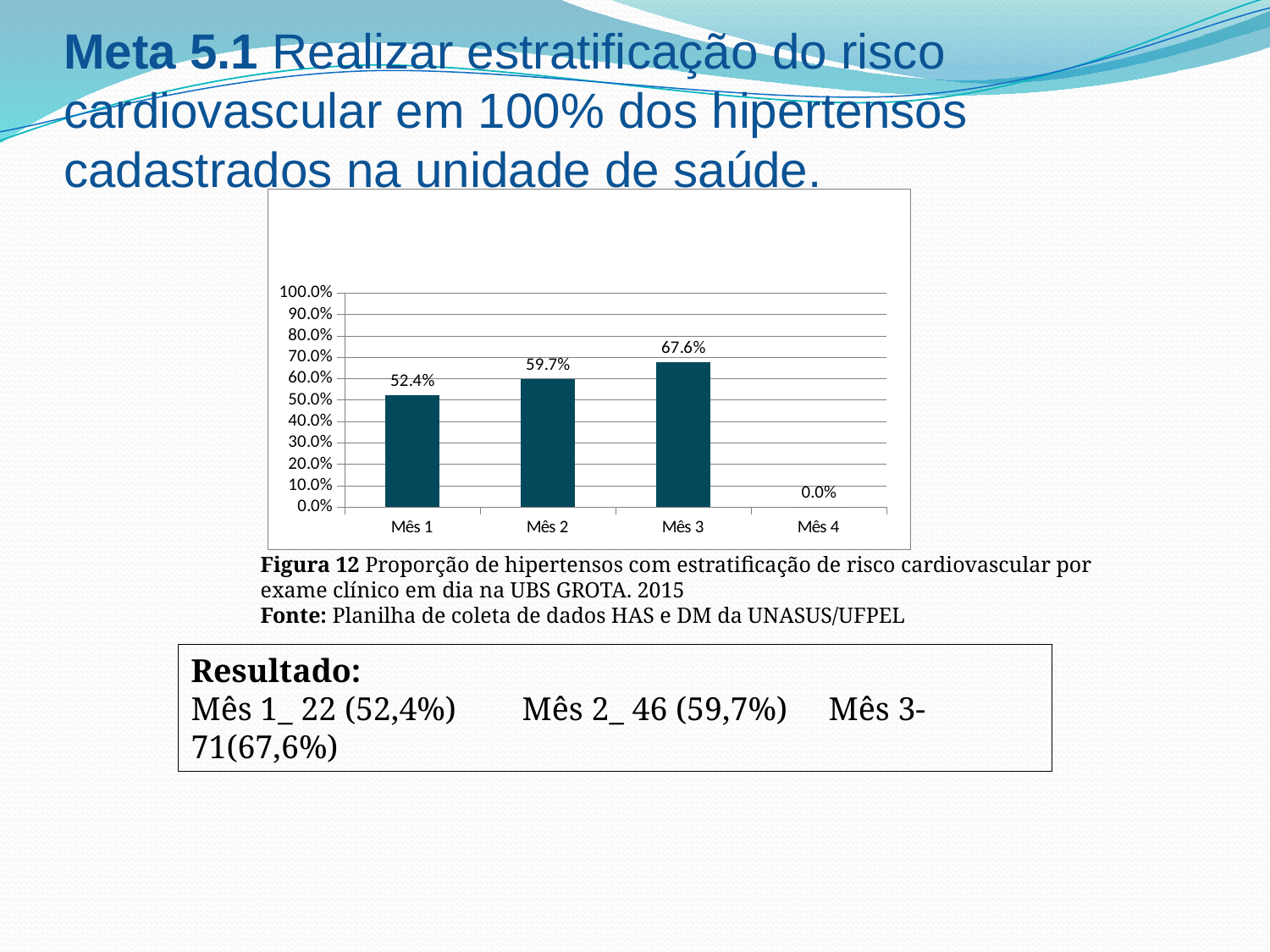
What is the difference between the values for Mês 3 and Mês 1? 15.2% Do the values rise or fall from Mês 1 to Mês 3? Rise Which is larger, the value for Mês 2 or the value for Mês 3? Mês 3 What is the difference between the values for Mês 2 and Mês 1? 7.3% What is the value for Mês 3? 67.6% Which category has the highest value? Mês 3 Which category has the lowest value? Mês 4 What kind of chart is shown on the slide? Bar chart What is the value for Mês 4? 0.0% What is the value for Mês 1? 52.4% How many categories are shown on the x axis? 4 What is the value for Mês 2? 59.7%